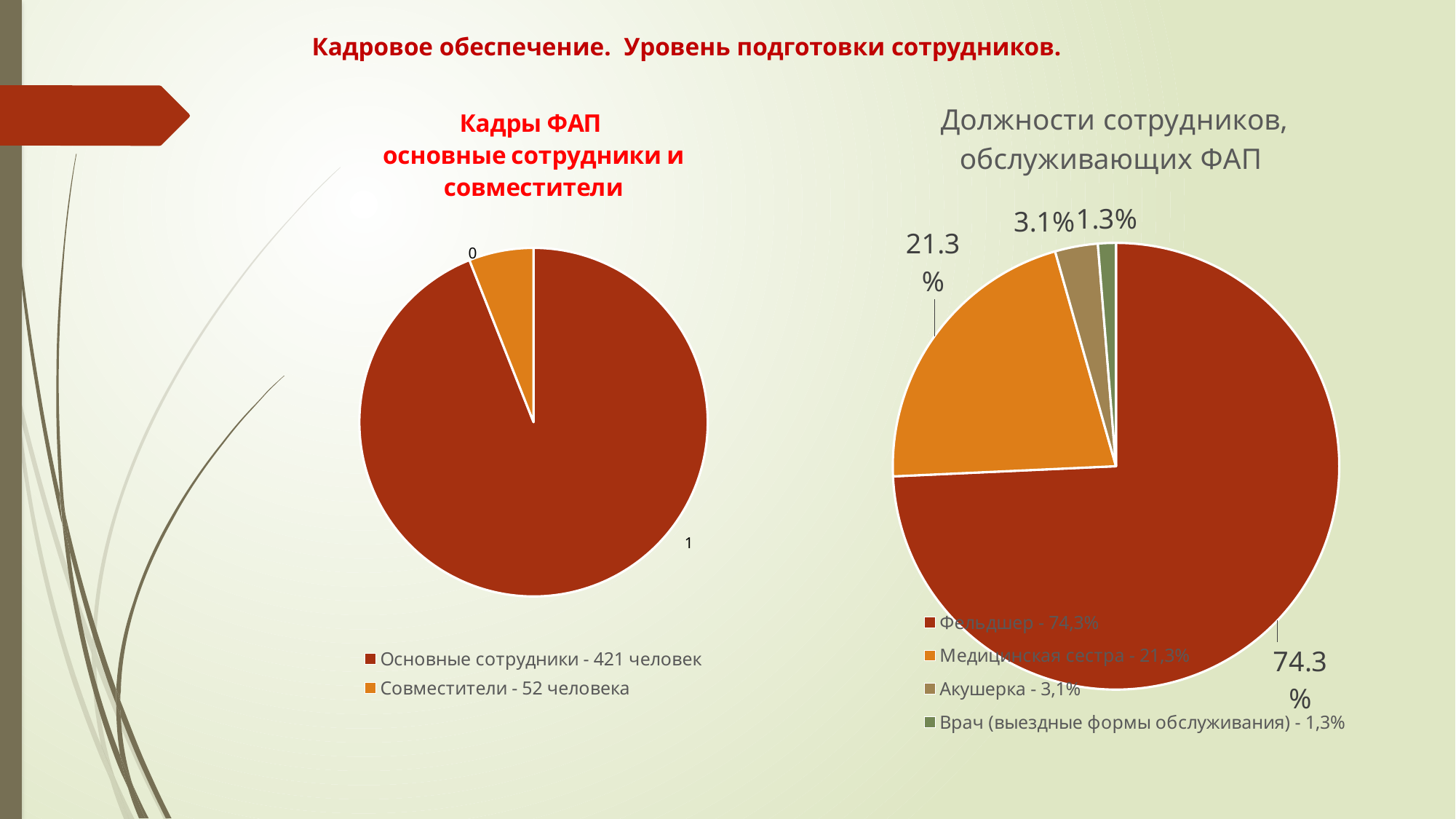
In the chart titled "Должности сотрудников, обслуживающих ФАП", what share of the pie is Фельдшер? 74.3% In the chart titled "Кадры ФАП основные сотрудники и совместители", what colour is the slice for Совместители? orange In the chart titled "Должности сотрудников, обслуживающих ФАП", which category has the smallest slice? Врач (выездные формы обслуживания) In the chart titled "Должности сотрудников, обслуживающих ФАП", what share of the pie is Акушерка? 3.1% In the chart titled "Должности сотрудников, обслуживающих ФАП", what is the difference in percentage points between Фельдшер and Медицинская сестра? 53 percentage points In the chart titled "Должности сотрудников, обслуживающих ФАП", what share of the pie is Медицинская сестра? 21.3% In the chart titled "Кадры ФАП основные сотрудники и совместители", how many people are Совместители according to the legend? 52 человека What kind of chart is the chart titled "Должности сотрудников, обслуживающих ФАП"? pie chart In the chart titled "Кадры ФАП основные сотрудники и совместители", which group is larger, Основные сотрудники or Совместители? Основные сотрудники In the chart titled "Должности сотрудников, обслуживающих ФАП", how many categories does the legend list? 4 In the chart titled "Кадры ФАП основные сотрудники и совместители", how many people are Основные сотрудники according to the legend? 421 человек In the chart titled "Должности сотрудников, обслуживающих ФАП", which category has the largest slice? Фельдшер